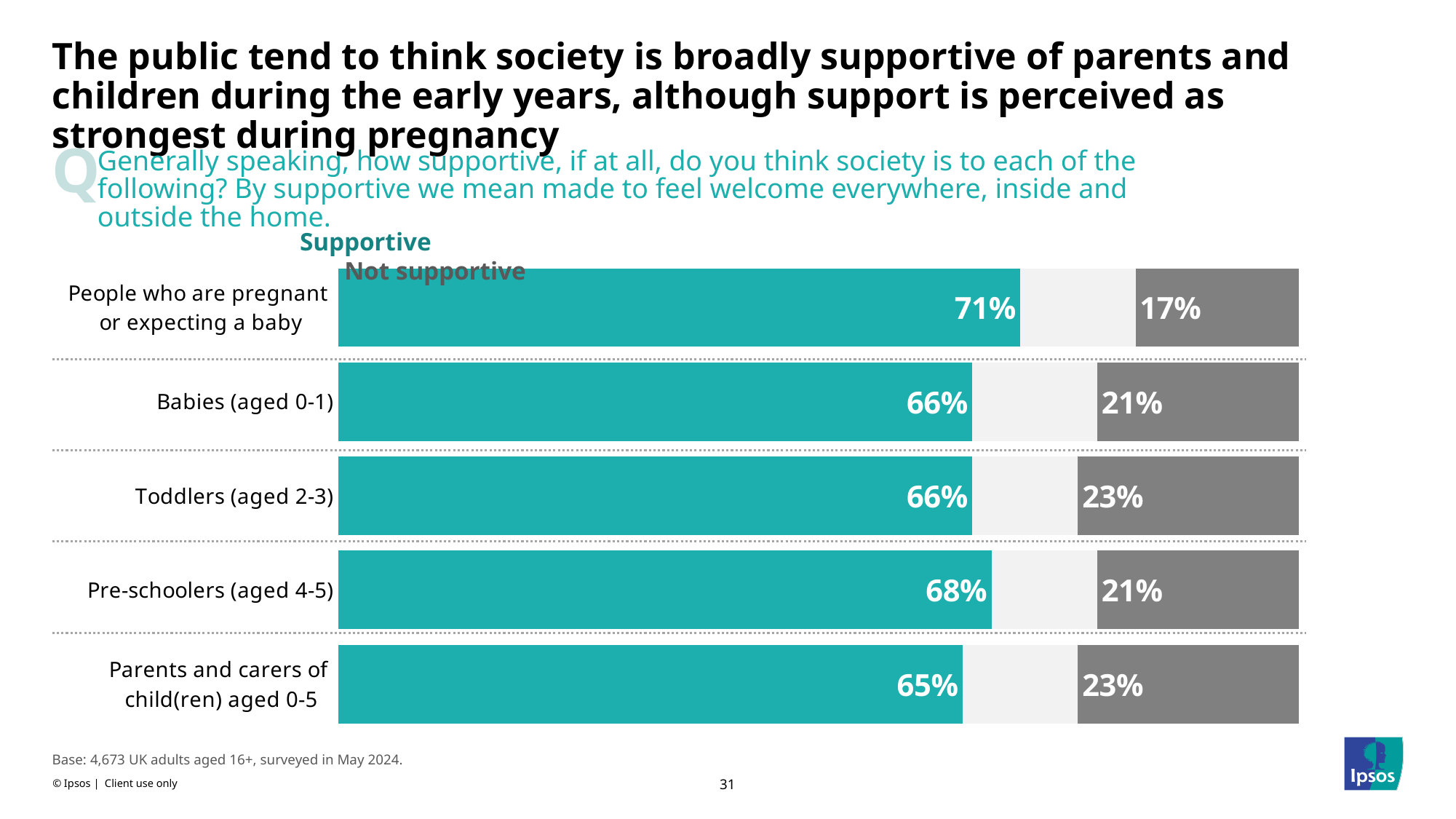
What is the 'Supportive' value for Pre-schoolers (aged 4-5)? 68% What percentage think society is supportive of people who are pregnant or expecting a baby? 71% Which category has the lowest 'Not supportive' percentage? People who are pregnant or expecting a baby How many categories are shown in the chart? 5 What is the difference between the 'Supportive' values for people who are pregnant or expecting a baby and for Parents and carers of child(ren) aged 0-5? 6 percentage points What is the 'Not supportive' value for Babies (aged 0-1)? 21% What is the 'Not supportive' value for Toddlers (aged 2-3)? 23% Is the 'Supportive' value larger for Pre-schoolers (aged 4-5) or for Babies (aged 0-1)? Pre-schoolers (aged 4-5) What type of chart is shown on the slide? Stacked bar chart Which category has the lowest 'Supportive' percentage? Parents and carers of child(ren) aged 0-5 Which category has the highest 'Supportive' percentage? People who are pregnant or expecting a baby